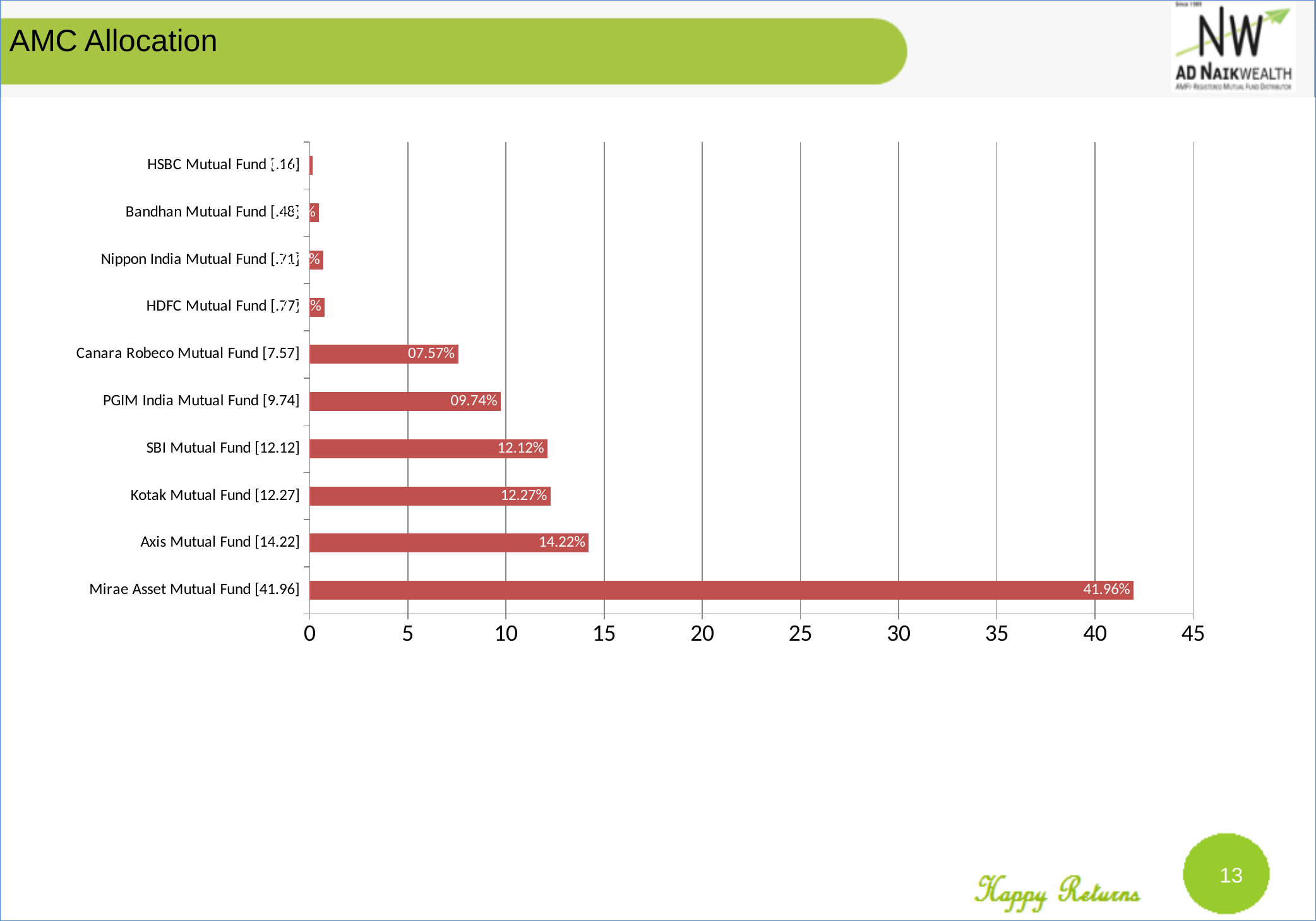
Which fund has the lowest allocation? HSBC Mutual Fund Which fund has the highest allocation? Mirae Asset Mutual Fund What kind of chart is shown on the slide? Bar chart How many funds are shown in the chart? 10 What is the value for Axis Mutual Fund? 14.22% What is the value for Mirae Asset Mutual Fund? 41.96% What is the difference between the values for Mirae Asset Mutual Fund and Axis Mutual Fund? 27.74% What is the value for Canara Robeco Mutual Fund? 07.57% Is the value for Mirae Asset Mutual Fund greater or less than 40? greater What is the value for PGIM India Mutual Fund? 09.74% What is the difference between the values for PGIM India Mutual Fund and Canara Robeco Mutual Fund? 2.17% Which is larger, the value for Axis Mutual Fund or the value for Kotak Mutual Fund? Axis Mutual Fund